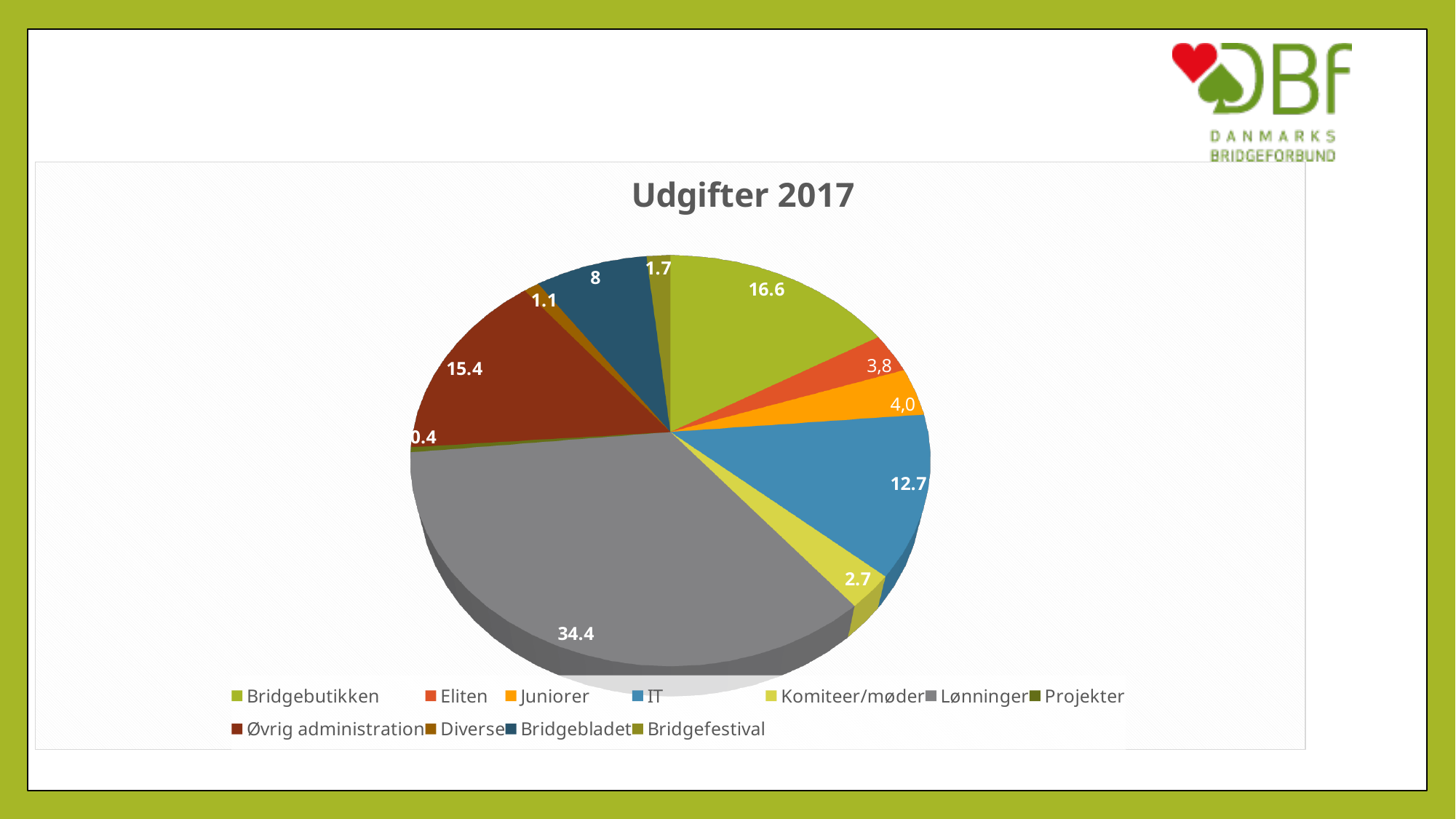
What is the value shown for Lønninger? 34.4 What is the value shown for Eliten? 3,8 Which category has the largest slice of the pie? Lønninger Which is larger, the value for Øvrig administration or the value for IT? Øvrig administration What is the title of the chart? Udgifter 2017 What is the value shown for Bridgebladet? 8 What is the value shown for Bridgebutikken? 16.6 Which category has the smallest slice of the pie? Projekter What is the difference between the values for Lønninger and Bridgebutikken? 17.8 What type of chart is shown on the slide? Pie chart What is the value shown for IT? 12.7 How many categories does the legend list? 11